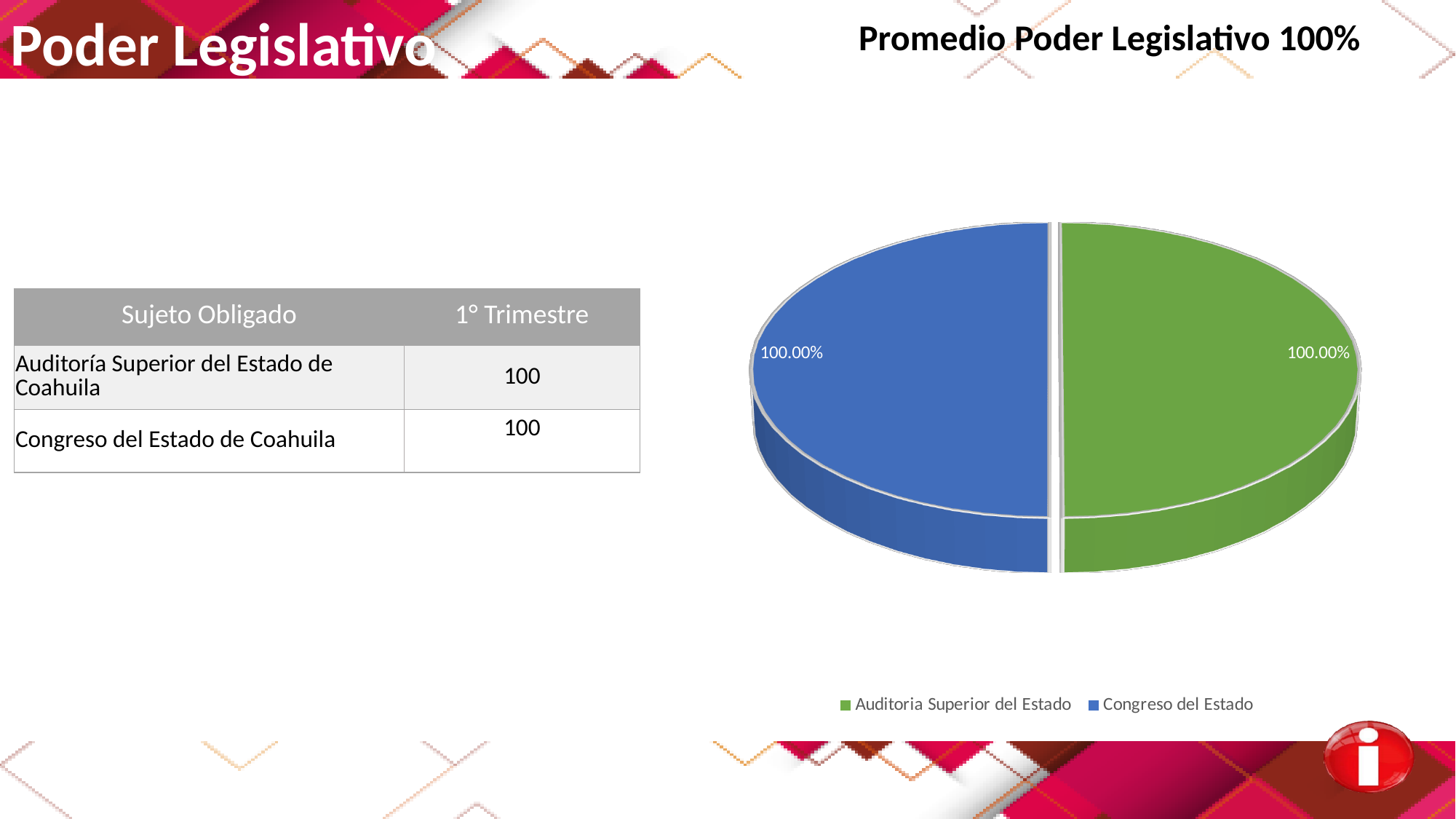
Which colour represents Auditoria Superior del Estado in the pie chart? Green Is the data label on the Congreso del Estado slice greater or less than 50%? greater What data label is shown on the Auditoria Superior del Estado slice of the pie chart? 100.00% How many entries does the legend of the pie chart list? 2 How many slices does the pie chart have? 2 What data label is shown on the Congreso del Estado slice of the pie chart? 100.00% What kind of chart is shown on the slide? Pie chart Which colour represents Congreso del Estado in the pie chart? Blue Which legend entry is listed first in the pie chart's legend? Auditoria Superior del Estado